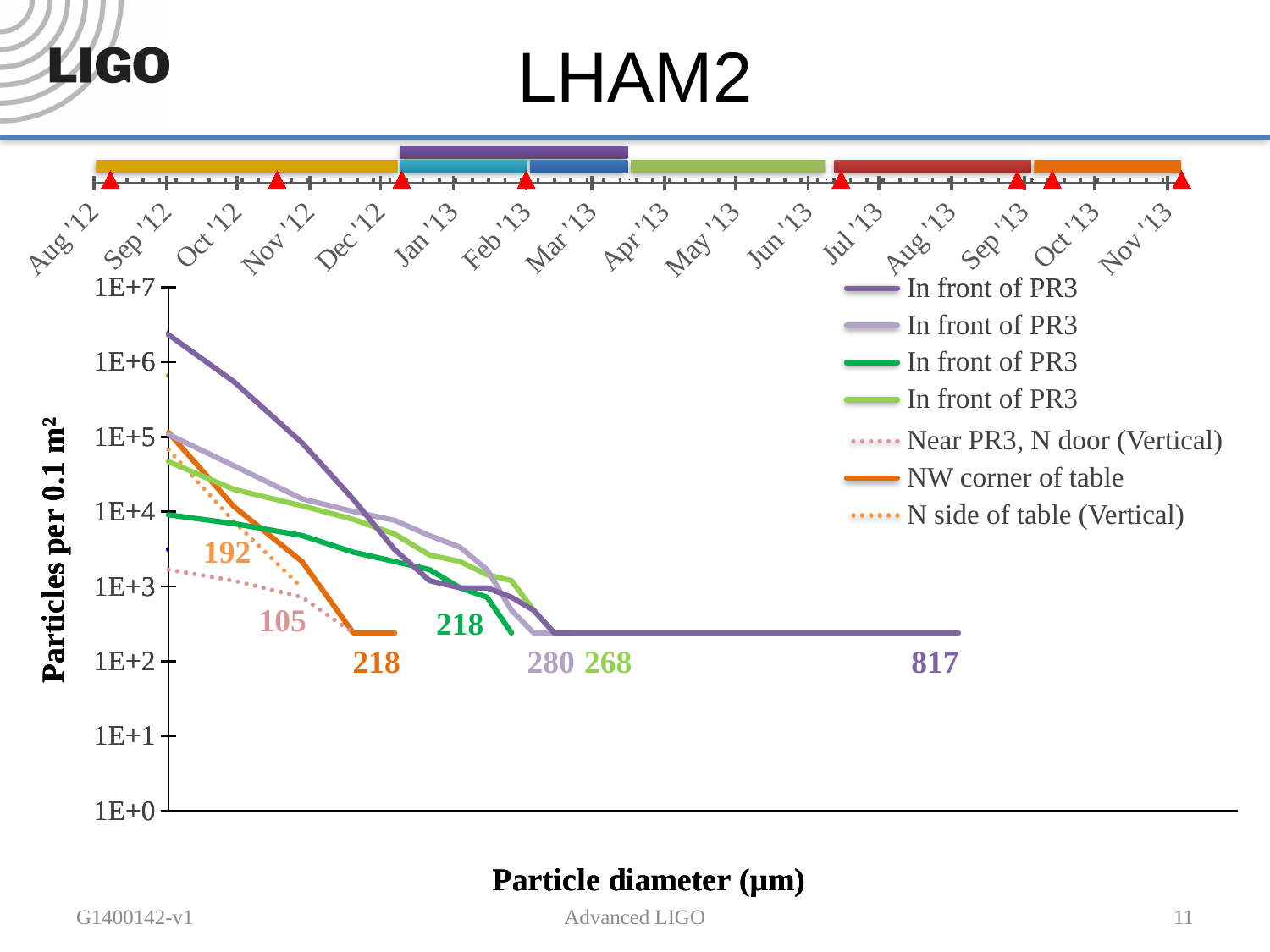
What number is printed at the end of the 'NW corner of table' line? 218 Is the starting value of the dotted 'Near PR3, N door (Vertical)' line greater or less than 1E+4? less What is the title of the y axis of the chart? Particles per 0.1 m² How many series does the chart legend list? 7 Is the value at which the 'NW corner of table' line flattens out greater or less than 1E+3? less Is the starting value of the dark purple 'In front of PR3' line greater or less than 1E+6? greater What number is printed at the end of the dark purple 'In front of PR3' line? 817 What is the title of the x axis of the chart? Particle diameter (µm) Which series reaches the highest value on the chart? In front of PR3 (dark purple line) What number is printed at the end of the dotted 'Near PR3, N door (Vertical)' line? 105 Do the plotted values rise or fall as particle diameter increases along the x axis? fall What kind of chart is shown on the slide? line chart